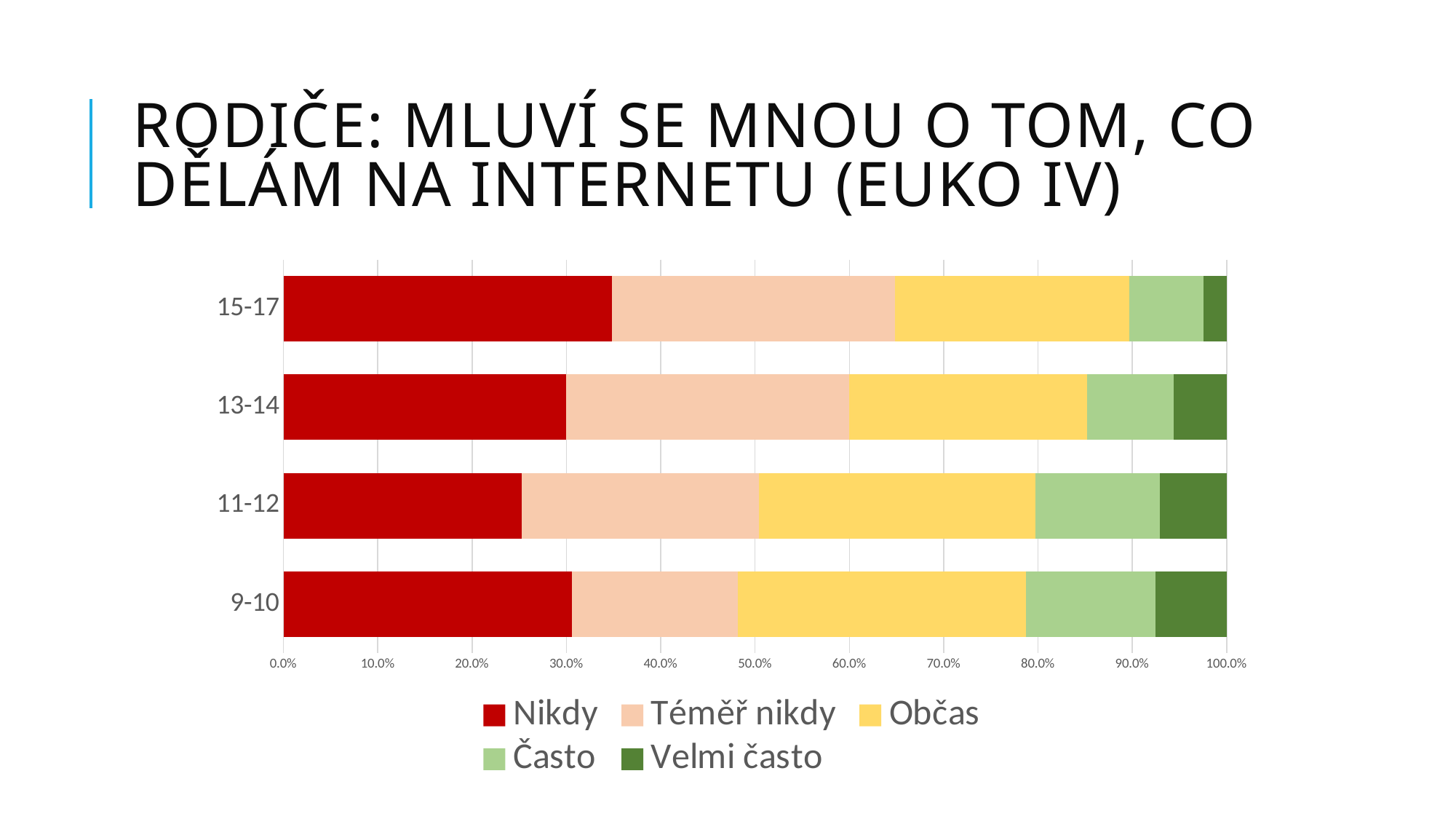
How many series does the legend list? 5 What kind of chart is shown on the slide? Stacked bar chart Which has a larger 'Velmi často' segment, the 13-14 group or the 15-17 group? 13-14 Which age group has the smallest 'Velmi často' segment? 15-17 Is the 'Nikdy' value for the 11-12 group greater or less than 30.0%? less Which series is shown in red on the chart? Nikdy What is the last entry in the chart legend? Velmi často Which age group has the smallest 'Nikdy' segment? 11-12 Is the 'Nikdy' value for the 15-17 group greater or less than 30.0%? greater Which age group has the largest 'Nikdy' segment? 15-17 How many age groups are shown on the chart? 4 Which has a larger 'Nikdy' segment, the 15-17 group or the 11-12 group? 15-17